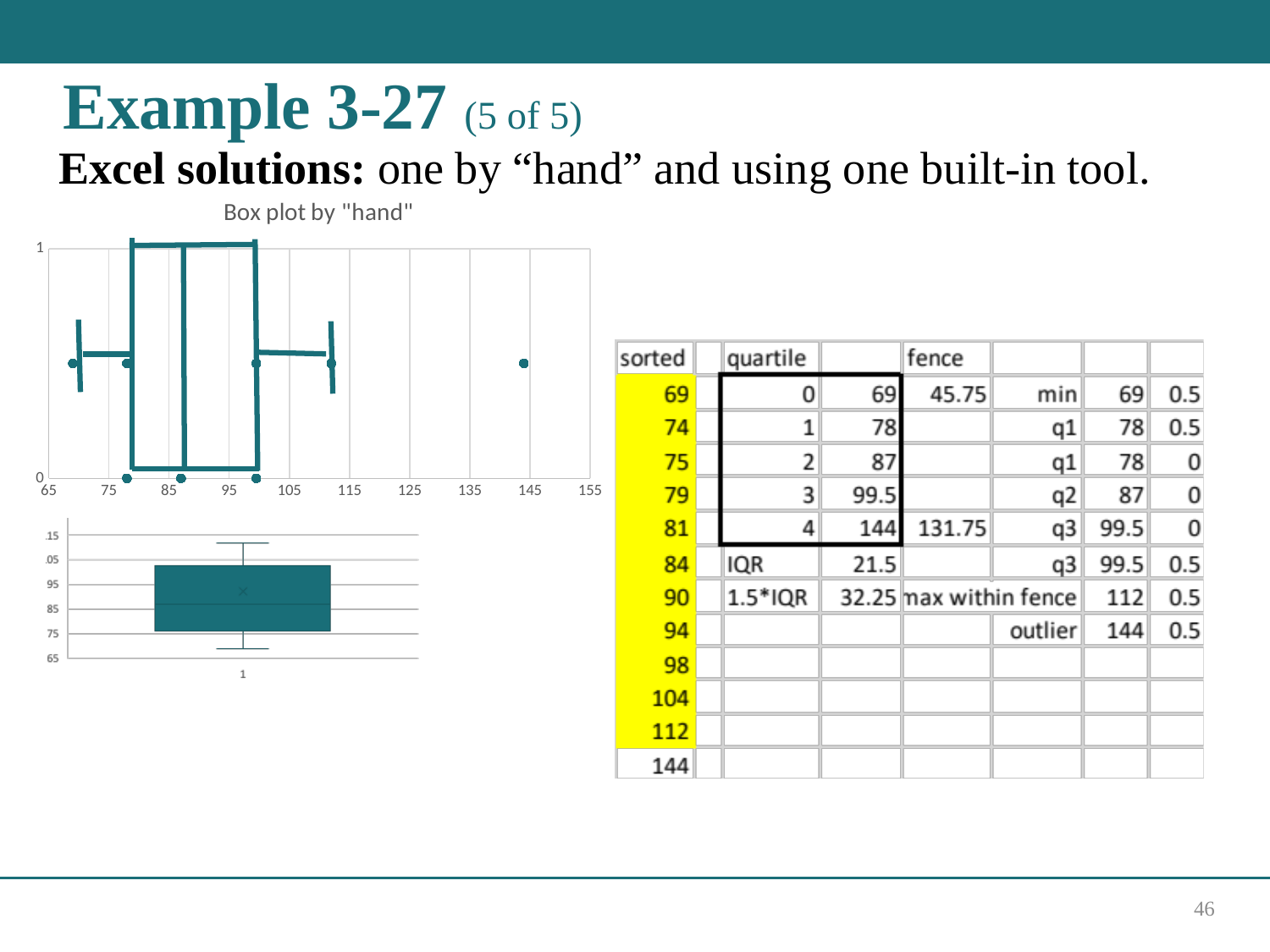
In the top chart, is the right edge of the box greater or less than 95? greater In the top chart, is the leftmost point (end of the lower whisker) greater or less than 75? less In the top chart, is the end of the upper whisker greater or less than 105? greater How many categories are shown on the x axis of the bottom-left chart? 1 What kind of chart is the bottom-left chart? box plot What are the lowest and highest values labelled on the x axis of the top chart? 65 and 155 What is the title of the top chart? Box plot by "hand" What kind of chart is the top chart titled Box plot by "hand"? box plot